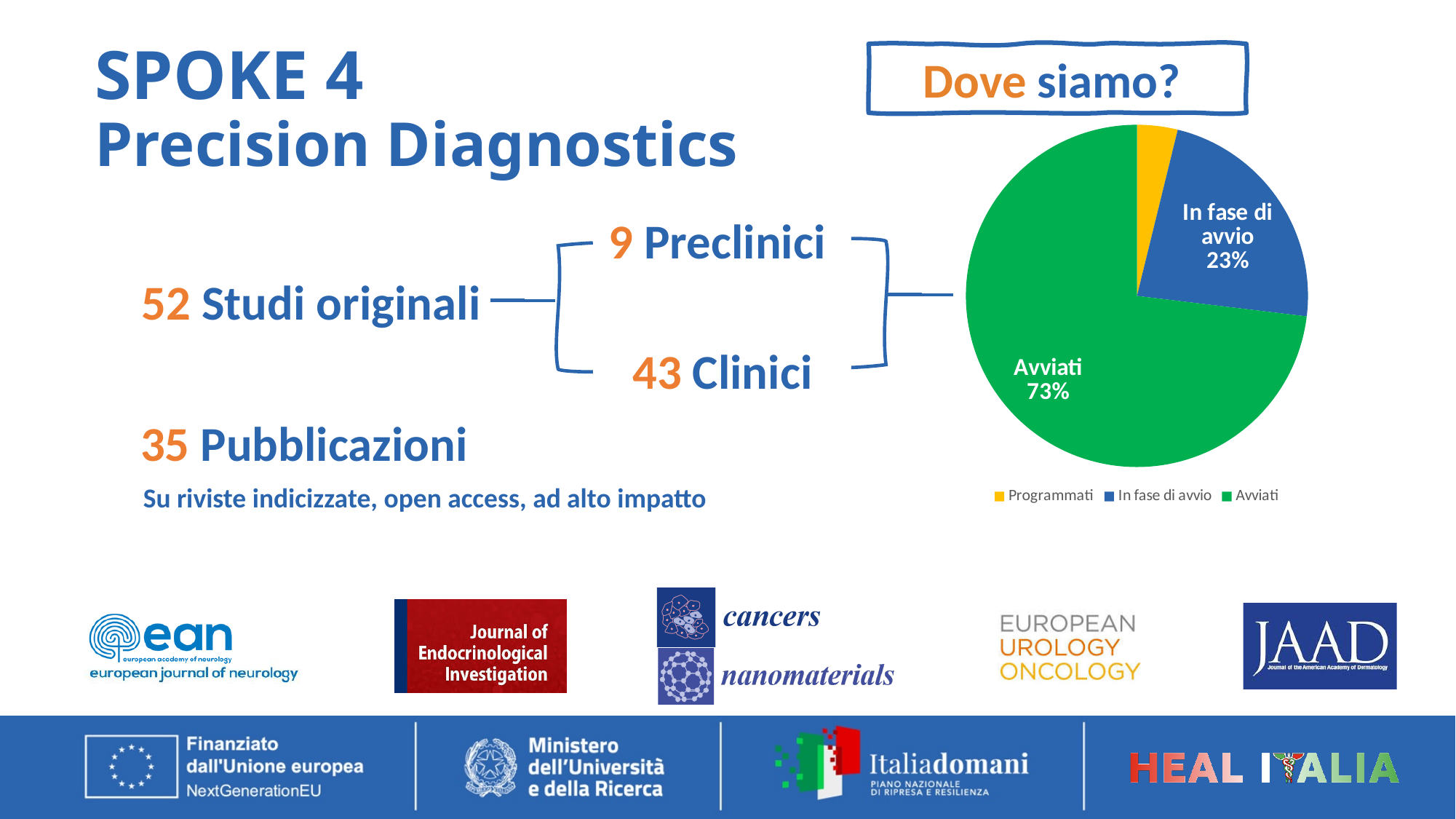
Which is larger in the pie chart, Avviati or In fase di avvio? Avviati What kind of chart is shown on the slide? Pie chart What is the difference in percentage points between the Avviati and In fase di avvio slices? 50 What percentage does the In fase di avvio slice show? 23% What colour is the Avviati slice in the pie chart? Green How many categories does the pie chart legend list? 3 What is the title shown above the pie chart? Dove siamo? Which category has the largest slice of the pie chart? Avviati Which category has the smallest slice of the pie chart? Programmati What share of the pie chart is labelled Avviati? 73%